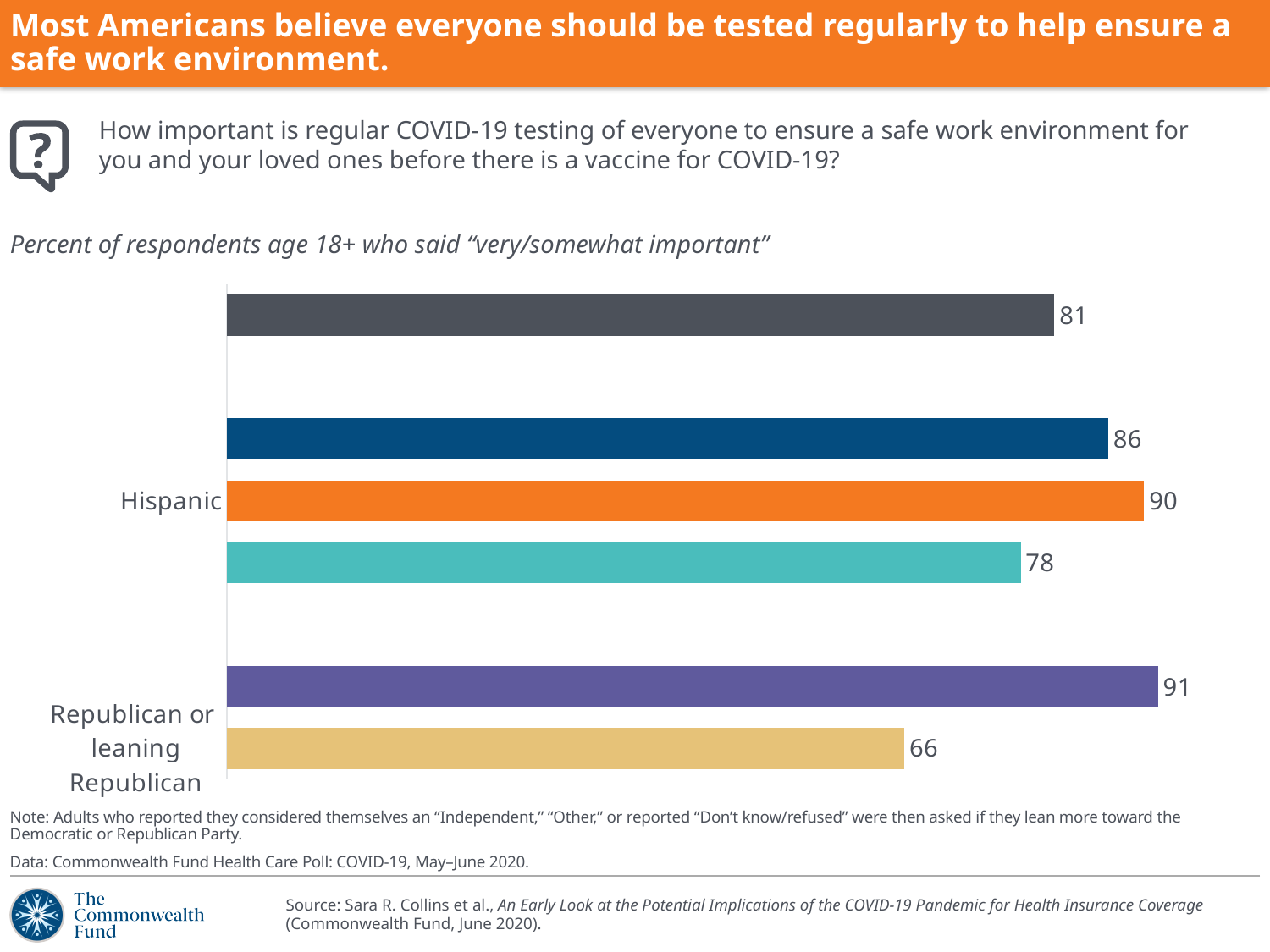
What is the difference between the value for Hispanic respondents and the value for Republican or leaning Republican respondents? 24 What is the value of the topmost bar in the chart? 81 How many bars are plotted in the chart? 6 Which is larger, the value for Hispanic respondents or the value for Republican or leaning Republican respondents? Hispanic What is the lowest value shown on any bar in the chart? 66 According to the subtitle, what response did the percentages represent? very/somewhat important What percent of Hispanic respondents said regular COVID-19 testing is very/somewhat important? 90 What is the title of the slide? Most Americans believe everyone should be tested regularly to help ensure a safe work environment. Which labeled group has the lowest value on the chart? Republican or leaning Republican What is the highest value shown on any bar in the chart? 91 What is the value for respondents who are Republican or leaning Republican? 66 What kind of chart is shown on the slide? bar chart